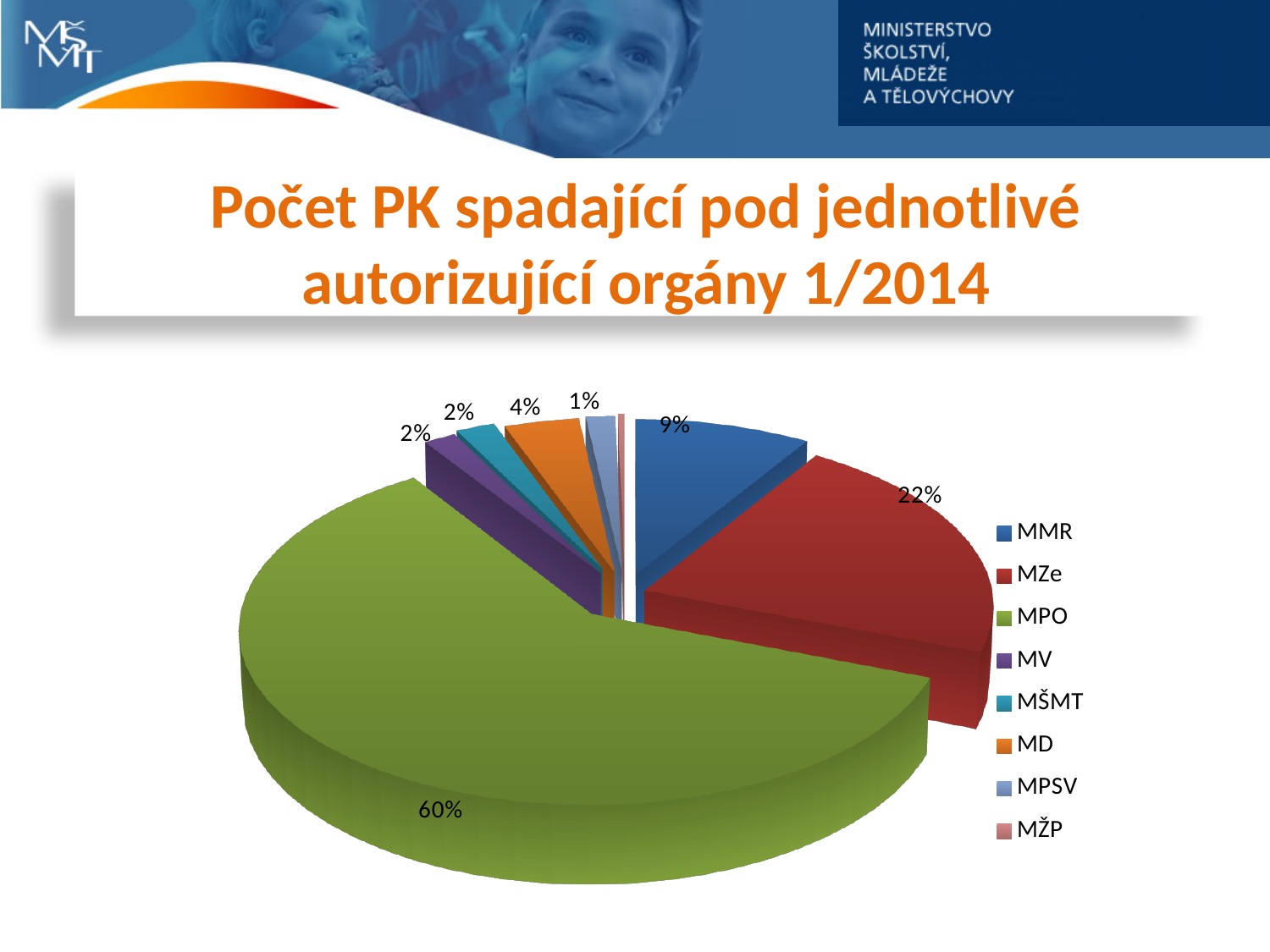
What is the difference in percentage points between the MPO share and the MZe share? 38 What share of the pie does MMR hold? 9% What is the title of the chart on the slide? Počet PK spadající pod jednotlivé autorizující orgány 1/2014 What share of the pie does MD hold? 4% What share of the pie does MZe hold? 22% Which is larger, the share for MZe or the share for MMR? MZe How many entries does the legend list? 8 What share of the pie does MPSV hold? 1% What share of the pie does MPO hold? 60% Which authorizing body has the largest share of the pie? MPO What is the difference in percentage points between the MMR share and the MD share? 5 What type of chart is shown on the slide? pie chart